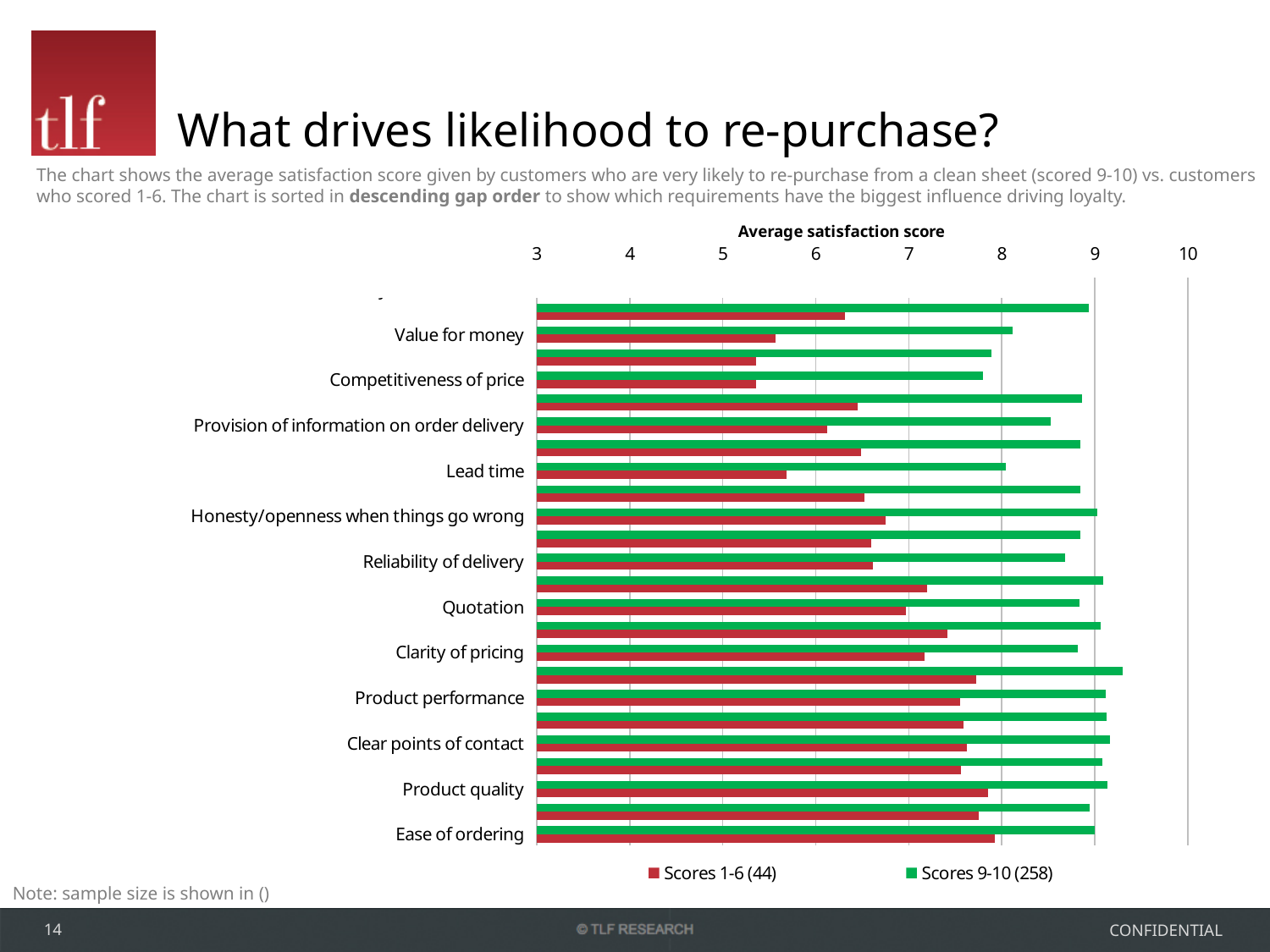
Is the Scores 1-6 (44) value for Product quality greater or less than 8? less For Value for money, which series has the larger value: Scores 1-6 (44) or Scores 9-10 (258)? Scores 9-10 (258) What kind of chart is shown on the slide? bar chart Is the Scores 9-10 (258) value for Provision of information on order delivery greater or less than 8? greater What are the two series named in the legend? Scores 1-6 (44) and Scores 9-10 (258) What is the title shown above the horizontal axis of the chart? Average satisfaction score Is the Scores 9-10 (258) value for Clear points of contact greater or less than 9? greater For the Scores 1-6 (44) series, which is larger: Value for money or Ease of ordering? Ease of ordering How many series does the legend list? 2